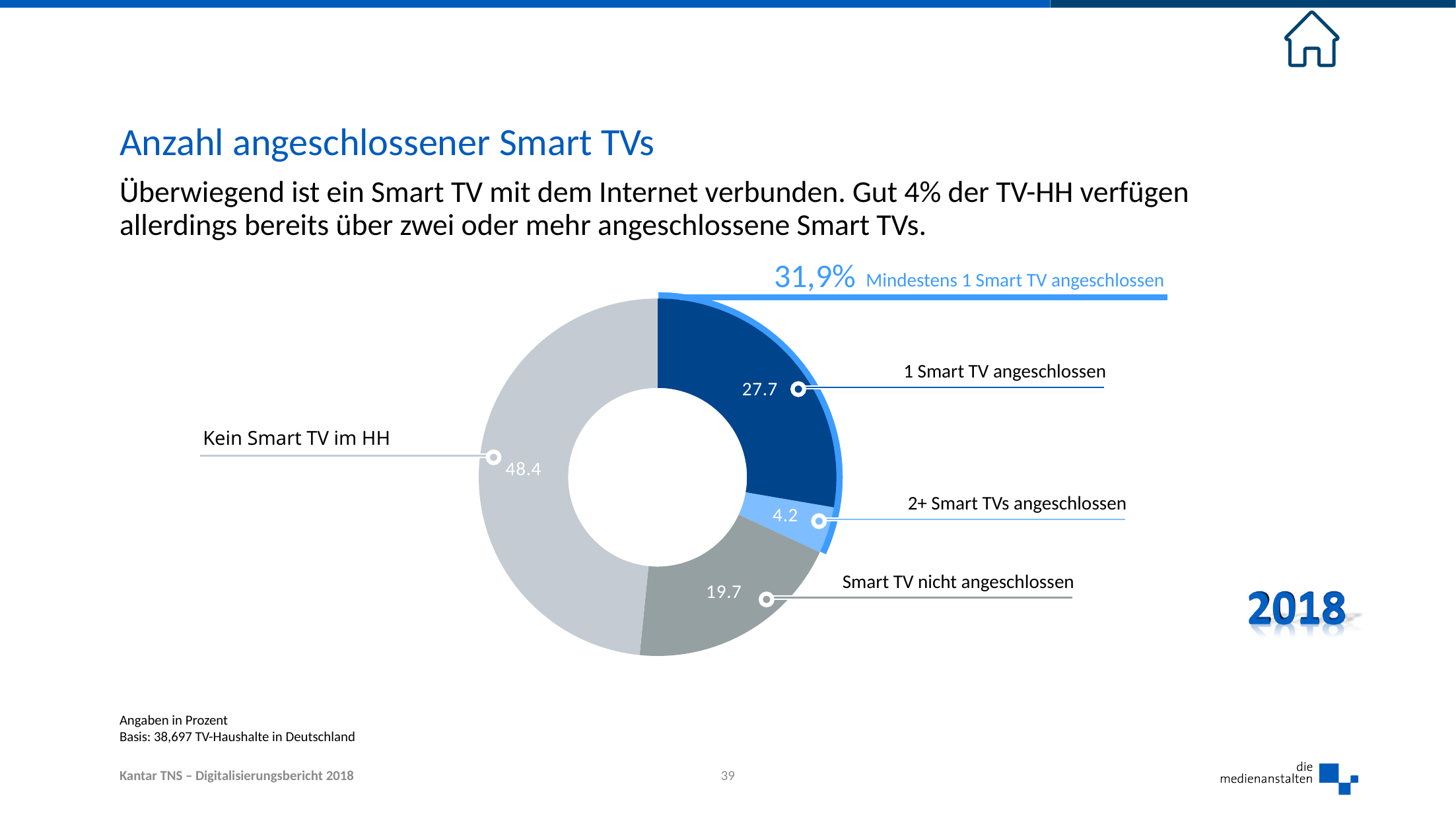
Which is larger, the value for "Smart TV nicht angeschlossen" or the value for "1 Smart TV angeschlossen"? 1 Smart TV angeschlossen What percentage is given for "Mindestens 1 Smart TV angeschlossen"? 31,9% Which category has the largest share of the chart? Kein Smart TV im HH How many categories does the chart show? 4 Which category has the smallest share of the chart? 2+ Smart TVs angeschlossen What is the difference between the values for "Kein Smart TV im HH" and "1 Smart TV angeschlossen"? 20.7 What kind of chart is shown on the slide? Doughnut chart What is the value for "1 Smart TV angeschlossen"? 27.7 What is the value for "Kein Smart TV im HH"? 48.4 What is the value for "Smart TV nicht angeschlossen"? 19.7 What is the title of the chart on the slide? Anzahl angeschlossener Smart TVs What is the value for "2+ Smart TVs angeschlossen"? 4.2